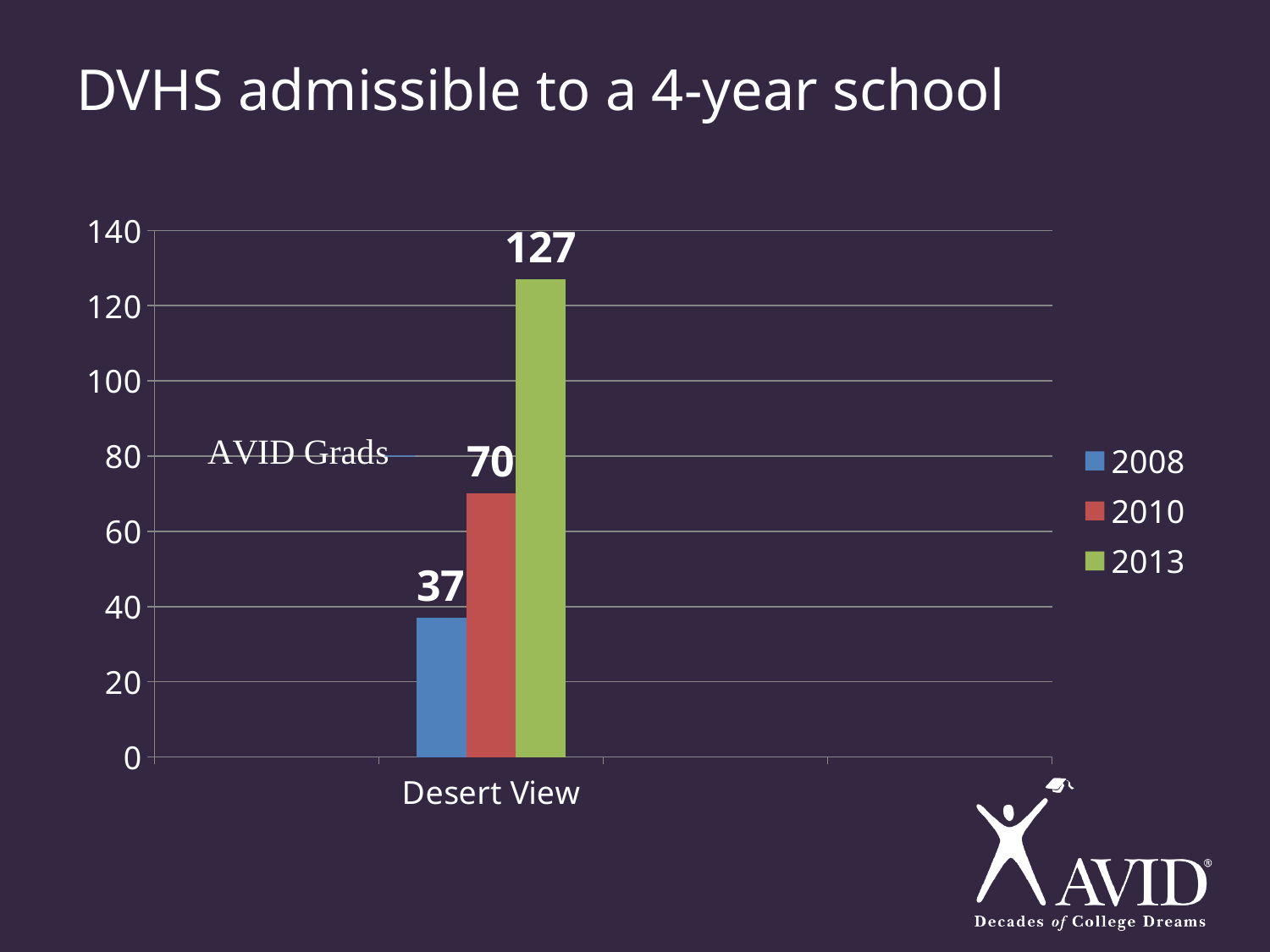
What kind of chart is shown on the slide? bar chart What is the value for 2013 for Desert View? 127 Which is larger for Desert View, the 2010 value or the 2013 value? 2013 What is the value for 2010 for Desert View? 70 What is the value for 2008 for Desert View? 37 Is the value for 2013 greater or less than 120? greater What is the difference between the 2010 and 2008 values for Desert View? 33 What is the difference between the 2013 and 2008 values for Desert View? 90 How many series does the legend list? 3 Which year has the lowest value for Desert View? 2008 Which year has the highest value for Desert View? 2013 What is the title of the slide? DVHS admissible to a 4-year school